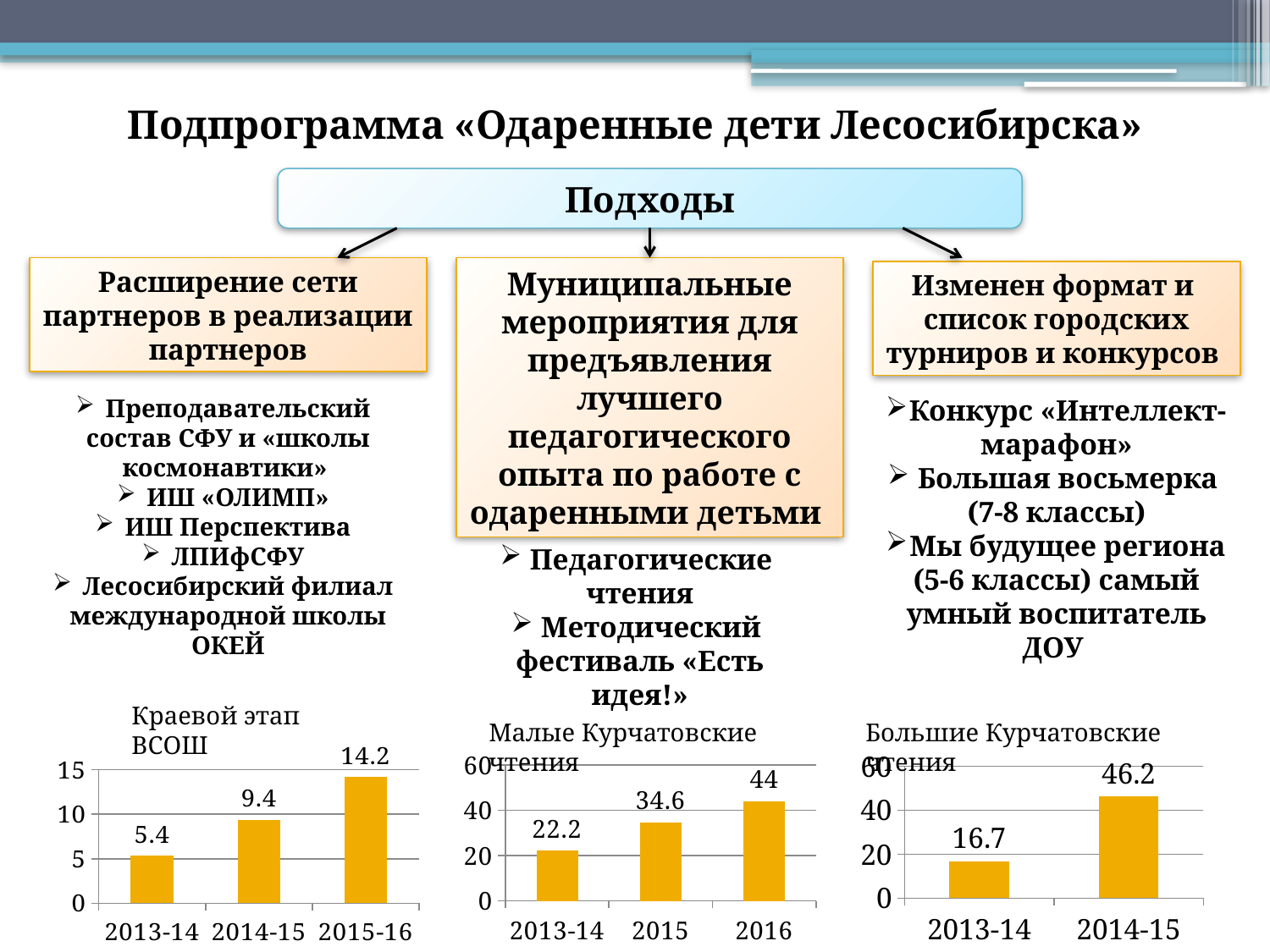
In the chart titled "Краевой этап ВСОШ", how many bars are plotted? 3 In the chart titled "Малые Курчатовские чтения", do the values rise or fall from 2013-14 to 2016? rise In the chart titled "Краевой этап ВСОШ", which category has the lowest value? 2013-14 In the chart titled "Краевой этап ВСОШ", what is the value for 2015-16? 14.2 In the chart titled "Краевой этап ВСОШ", what is the difference between the values for 2015-16 and 2013-14? 8.8 In the chart titled "Малые Курчатовские чтения", is the value for 2013-14 greater or less than 20? greater In the chart titled "Большие Курчатовские чтения", which is larger, the value for 2013-14 or 2014-15? 2014-15 In the chart titled "Малые Курчатовские чтения", what is the value for 2015? 34.6 In the chart titled "Большие Курчатовские чтения", what is the value for 2013-14? 16.7 What kind of chart is the chart titled "Большие Курчатовские чтения"? bar chart In the chart titled "Большие Курчатовские чтения", what is the difference between the values for 2014-15 and 2013-14? 29.5 In the chart titled "Малые Курчатовские чтения", which category has the highest value? 2016